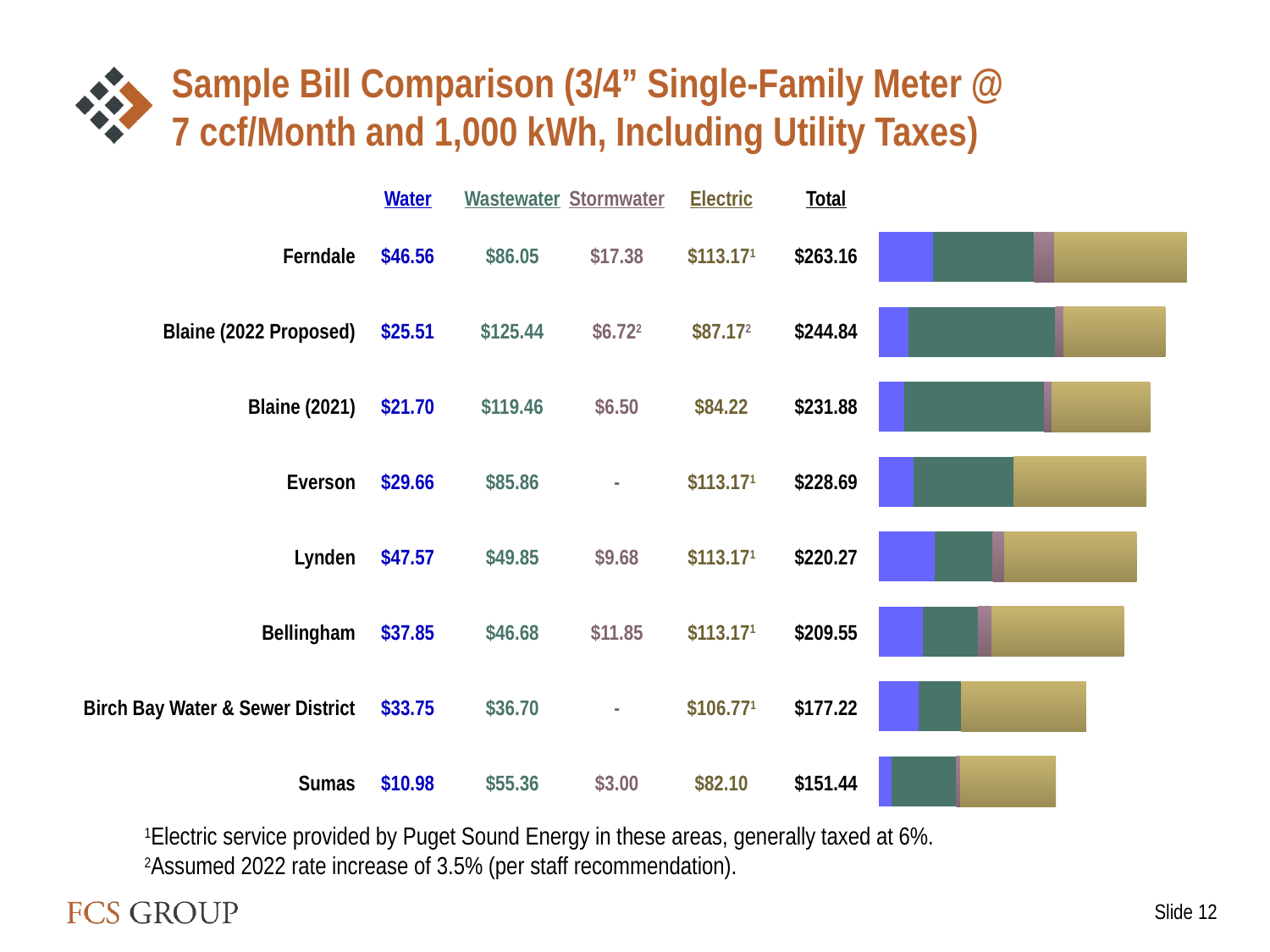
How many utility components (column headings) are stacked in each bar? 4 What is the Wastewater charge for Blaine (2022 Proposed)? $125.44 What is the Stormwater charge for Bellingham? $11.85 What type of chart is used to show the sample bills? Stacked horizontal bar chart Which jurisdiction has the highest total sample bill? Ferndale How many jurisdictions are shown as bars in the chart? 8 How much higher is the Blaine (2022 Proposed) total than the Blaine (2021) total? $12.96 What is the Water charge for Ferndale? $46.56 What is the difference between the total bill for Ferndale and the total bill for Sumas? $111.72 What is the Electric charge for Sumas? $82.10 Which jurisdiction has the lowest total sample bill? Sumas Which has the larger Water charge, Lynden or Bellingham? Lynden